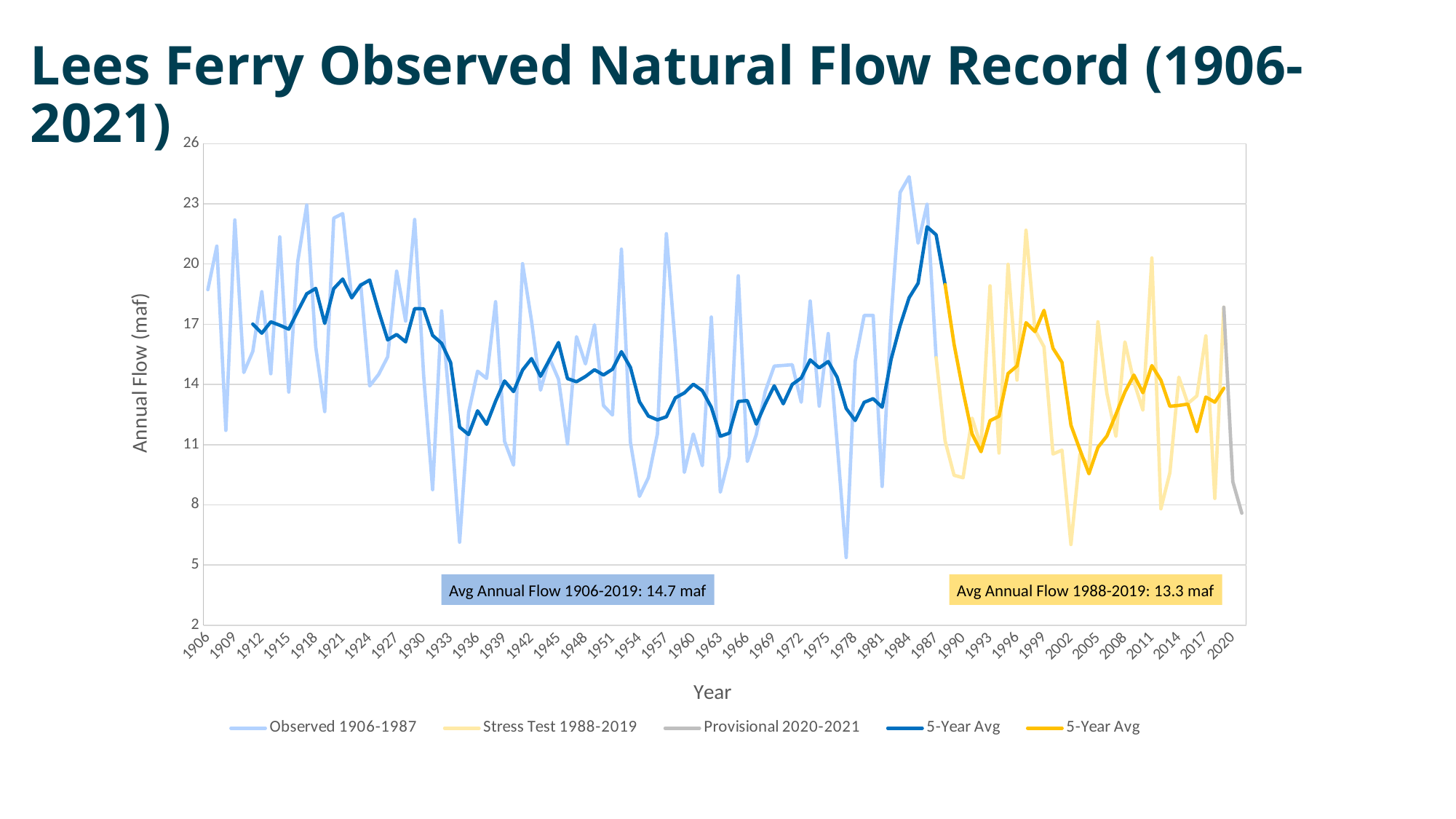
What kind of chart is shown on the slide? line chart In which year does the Stress Test 1988-2019 series reach its lowest value? 2002 How many series does the legend list? 5 What is the average annual flow for 1988-2019 shown in the annotation box? 13.3 maf Is the Observed 1906-1987 value for 1977 greater or less than 8? less Which is larger, the observed flow in 1983 or the stress test flow in 1997? 1983 Is the Observed 1906-1987 value for 1983 greater or less than 23? greater What is the label on the vertical axis? Annual Flow (maf) By how much does the 1906-2019 average annual flow exceed the 1988-2019 average annual flow? 1.4 maf What is the average annual flow for 1906-2019 shown in the annotation box? 14.7 maf In which year does the Observed 1906-1987 series reach its highest value? 1984 Is the Stress Test 1988-2019 value for 1997 greater or less than 20? greater